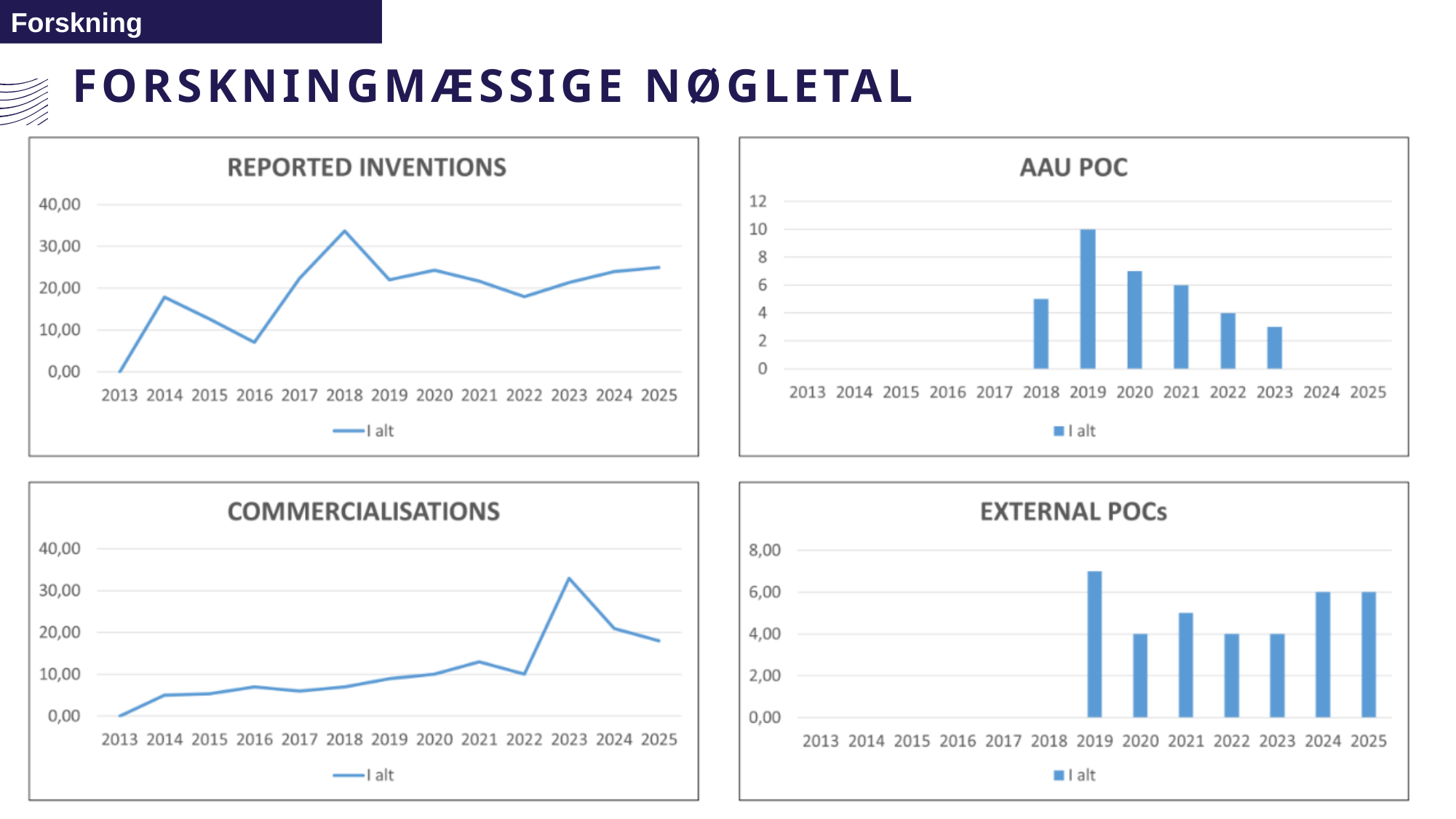
What kind of chart is the REPORTED INVENTIONS chart? line chart In the EXTERNAL POCs chart, which year has the highest value? 2019 In the AAU POC chart, what is the value for 2022? 4 How many series does the legend of the EXTERNAL POCs chart list? 1 In the AAU POC chart, what is the value for 2019? 10 In the AAU POC chart, which year has the highest value? 2019 What kind of chart is the AAU POC chart? bar chart In the EXTERNAL POCs chart, what is the value for 2024? 6,00 In the REPORTED INVENTIONS chart, which year has the highest value? 2018 In the REPORTED INVENTIONS chart, is the value for 2016 greater or less than 10,00? less